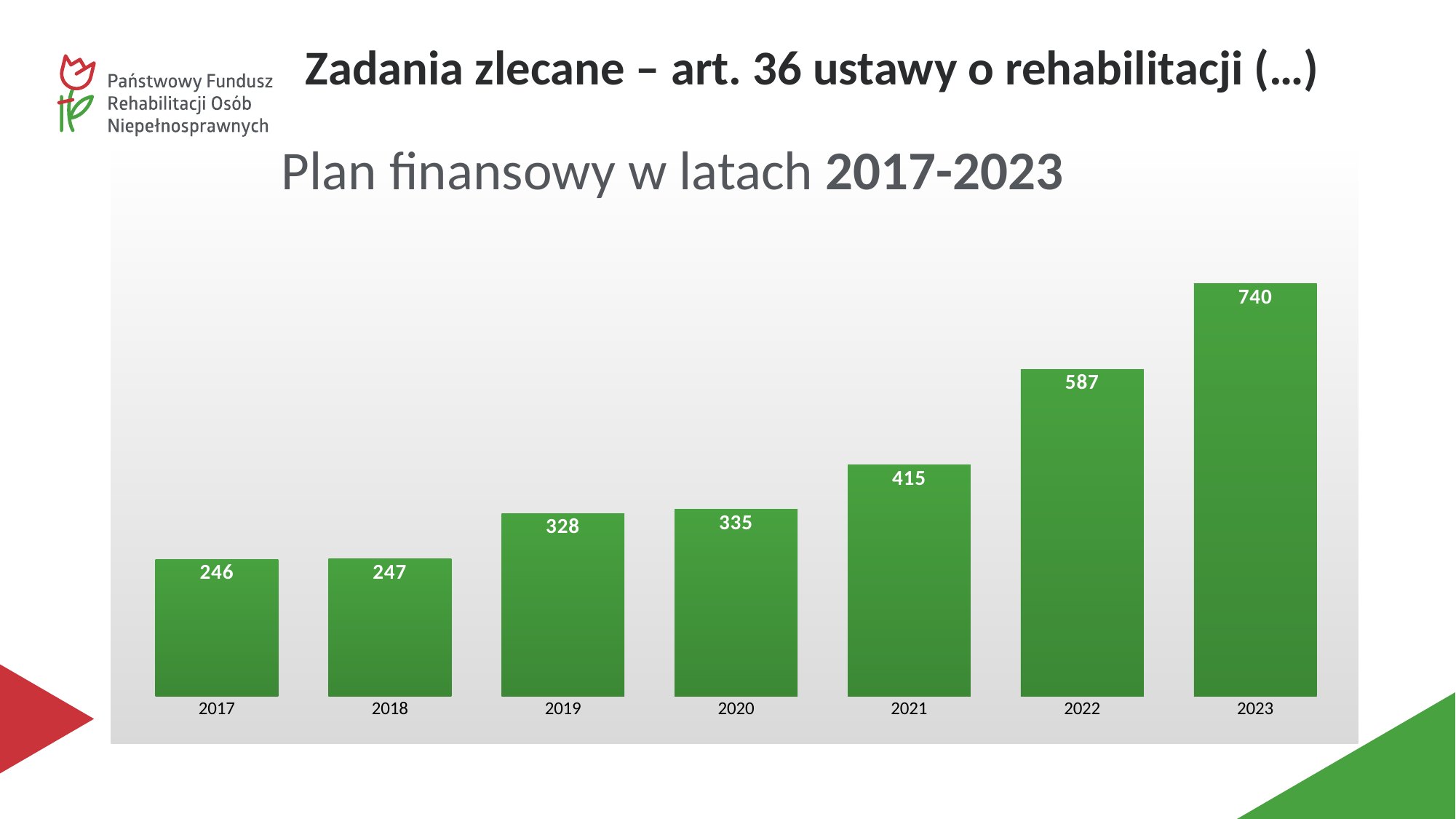
What kind of chart is shown? bar chart How many years are shown on the chart? 7 What is the value for 2017? 246 What is the difference between the values for 2023 and 2022? 153 What is the value for 2021? 415 What is the title of the chart? Plan finansowy w latach 2017-2023 Which year has the lowest value? 2017 Which year has the highest value? 2023 Which is larger, the value for 2020 or the value for 2021? 2021 What is the value for 2023? 740 Do the values rise or fall from 2017 to 2023? rise What is the difference between the values for 2019 and 2018? 81